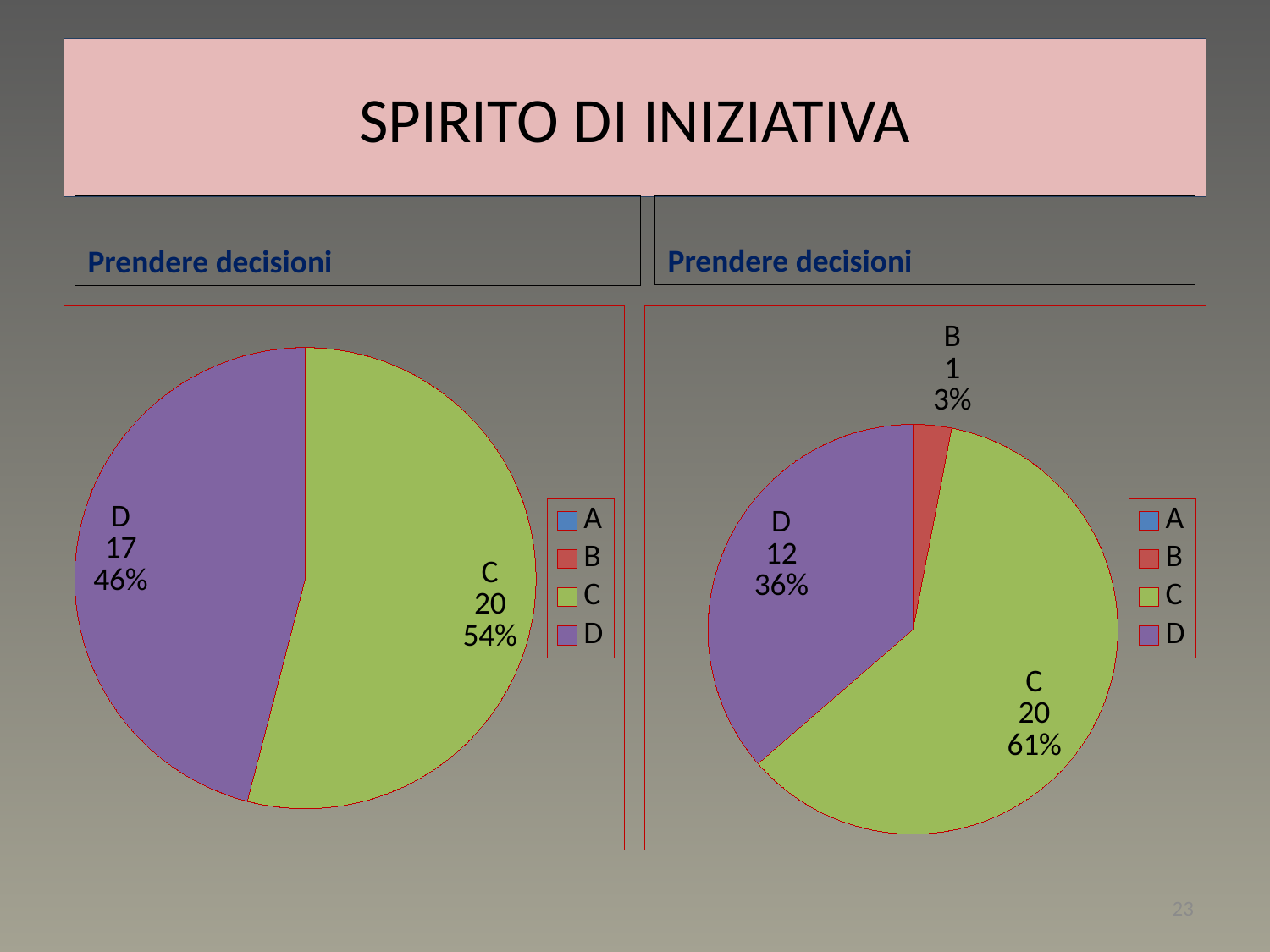
In the right pie chart, which category has the smallest slice? B In the left pie chart, which category has the largest slice? C In the right pie chart, what is the difference between the values for C and D? 8 In the left pie chart, what is the difference between the values for C and D? 3 In the left pie chart, what percentage share does category D have? 46% In the right pie chart, what is the value for category B? 1 What type of chart is shown on the left side of the slide? pie chart In the right pie chart, which is larger, the value for D or the value for B? D How many entries does the legend of the right pie chart list? 4 In the left pie chart, what is the value for category C? 20 In the right pie chart, what percentage share does category C have? 61% What is the title shown above the left pie chart? Prendere decisioni